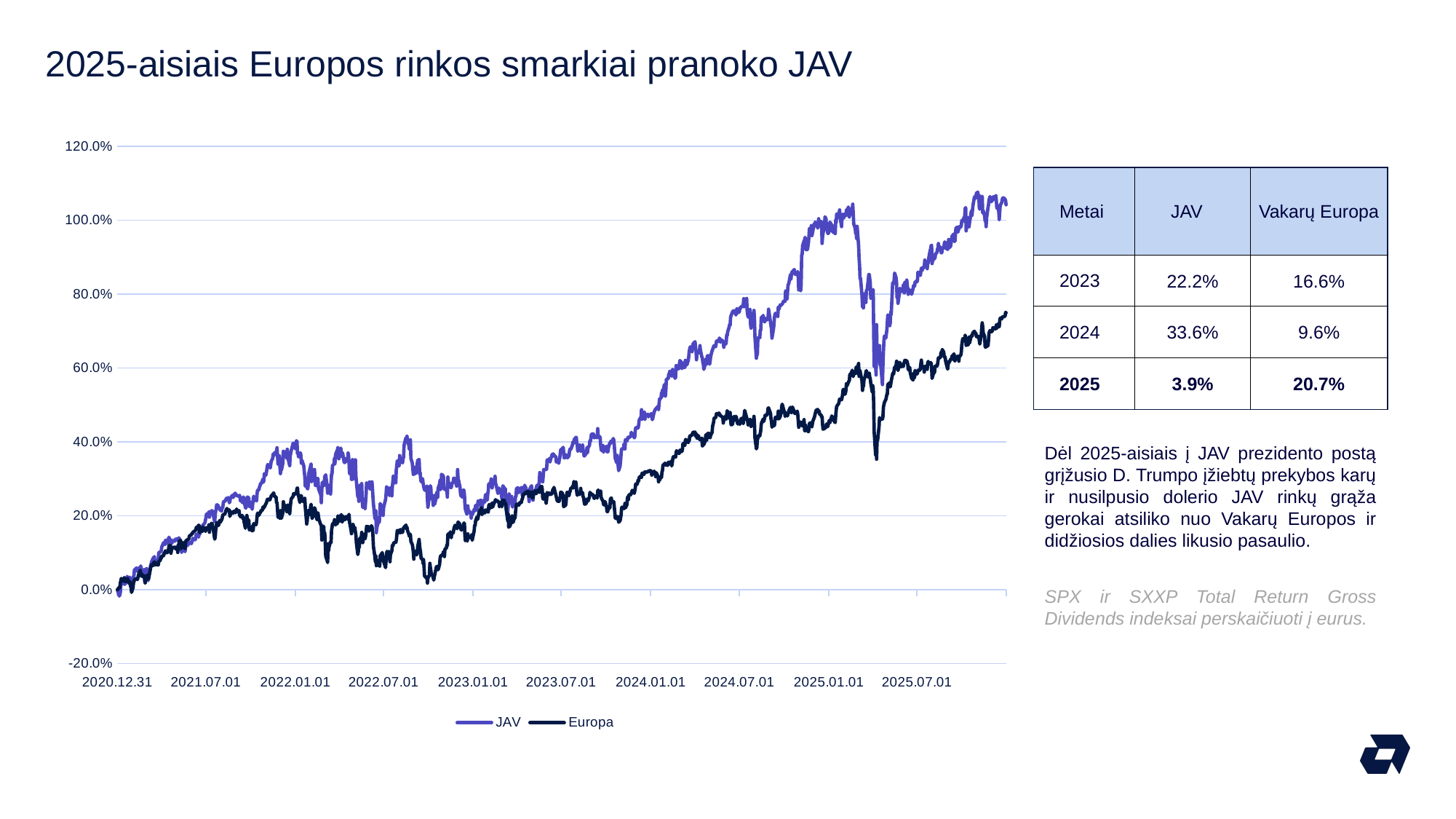
What kind of chart is shown on the slide? line chart How many date labels are shown on the x axis of the chart? 10 Is the value of the Europa series at the right end of the chart greater or less than 60.0%? greater Is the value of the JAV series around 2024.01.01 greater or less than 40.0%? greater How many series does the chart legend list? 2 Over the whole period shown, do the JAV and Europa series generally rise or fall from left to right? rise Which series is higher at the right end of the chart, JAV or Europa? JAV What are the two series named in the chart legend? JAV and Europa What is the title of the slide above the chart? 2025-aisiais Europos rinkos smarkiai pranoko JAV Is the highest point reached by the JAV series greater or less than 100.0%? greater